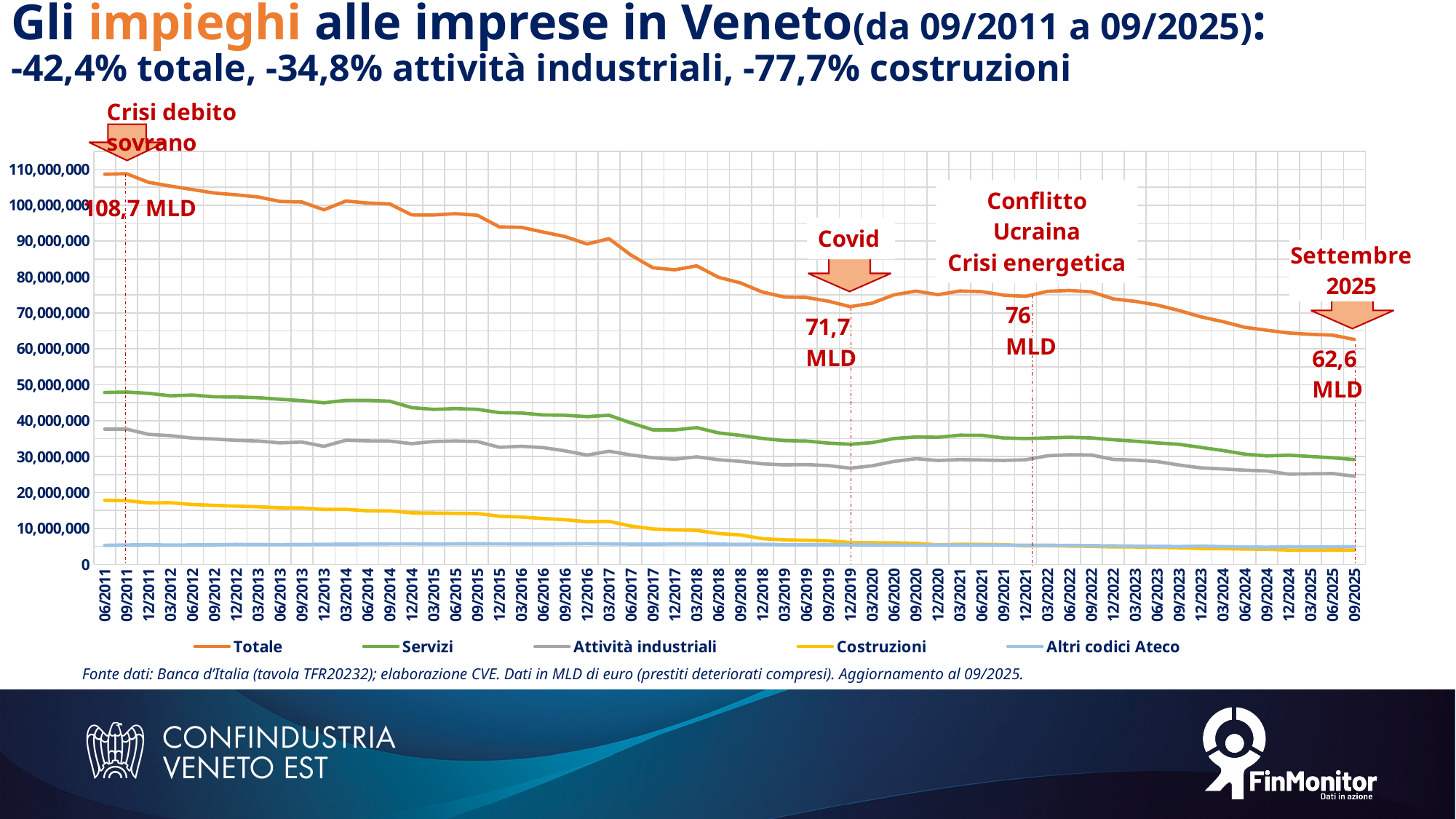
Does the Totale series rise or fall from 06/2011 to 09/2025? fall What is the value of the Totale series at 09/2011, as labelled on the chart? 108,7 MLD Is the value for Attività industriali at 09/2025 greater or less than 30,000,000? less How many series does the legend list? 5 What is the difference between the labelled Totale values at 09/2011 and 09/2025? 46,1 MLD What kind of chart is shown on the slide? line chart At 06/2011, which is larger: Servizi or Attività industriali? Servizi What is the value of the Totale series at 12/2019 (Covid), as labelled on the chart? 71,7 MLD Which series has the lowest value at 06/2011? Altri codici Ateco What is the value of the Totale series at 12/2021, as labelled on the chart? 76 MLD What is the value of the Totale series at 09/2025, as labelled on the chart? 62,6 MLD Which series has the highest values throughout the chart? Totale